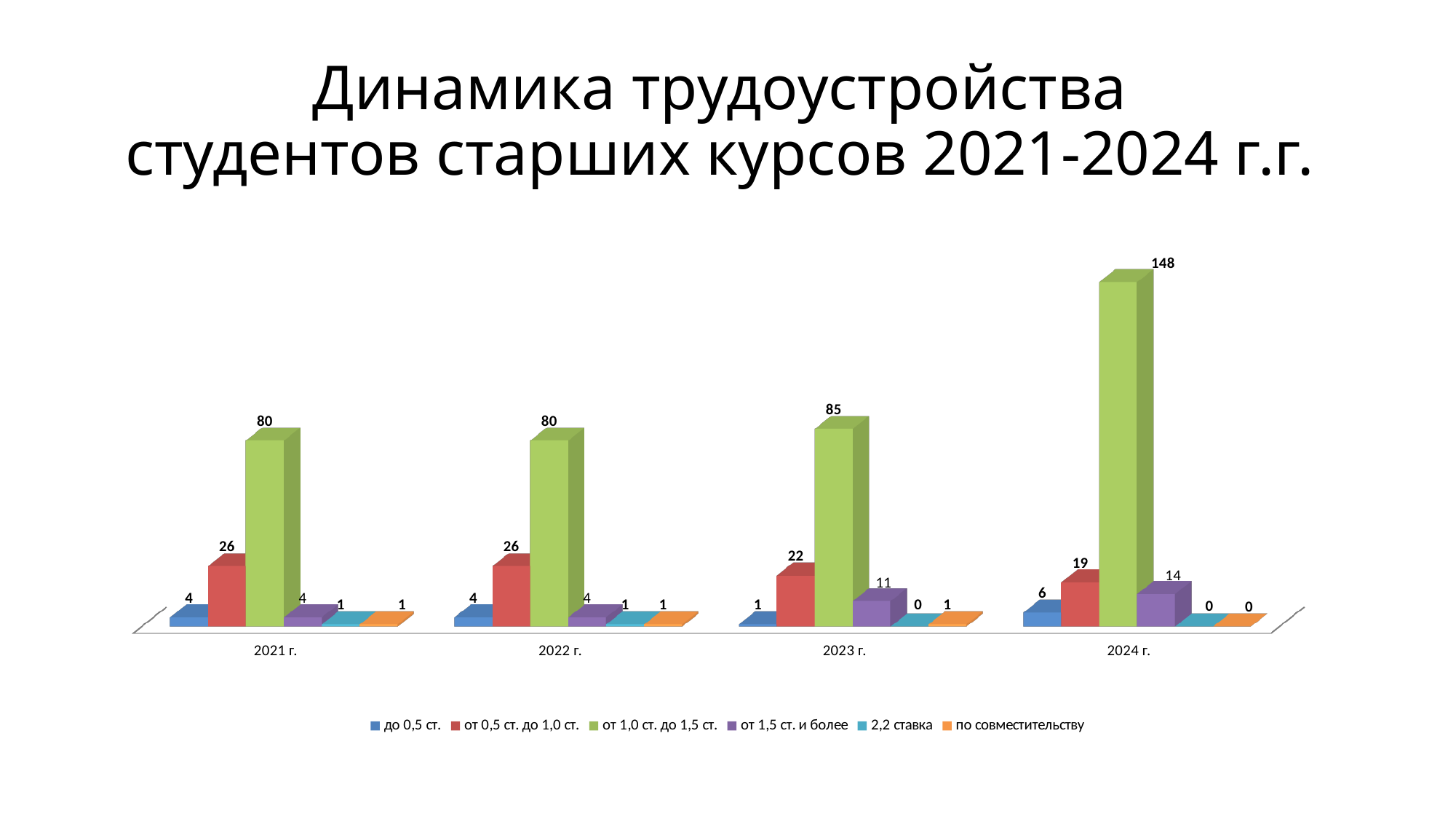
What is the value for "до 0,5 ст." in 2023 г.? 1 What is the value for "от 1,0 ст. до 1,5 ст." in 2024 г.? 148 Which is larger: the "от 1,5 ст. и более" value in 2023 г. or in 2024 г.? 2024 г. In which year is the value for "от 0,5 ст. до 1,0 ст." lowest? 2024 г. In which year is the value for "от 1,0 ст. до 1,5 ст." highest? 2024 г. What is the difference between the "от 1,0 ст. до 1,5 ст." values for 2024 г. and 2023 г.? 63 Does the value for "от 1,0 ст. до 1,5 ст." rise or fall from 2022 г. to 2024 г.? Rise What is the value for "от 0,5 ст. до 1,0 ст." in 2023 г.? 22 How many years are shown on the x axis? 4 What is the value for "от 1,5 ст. и более" in 2024 г.? 14 How many series does the legend list? 6 What kind of chart is shown on the slide? Bar chart